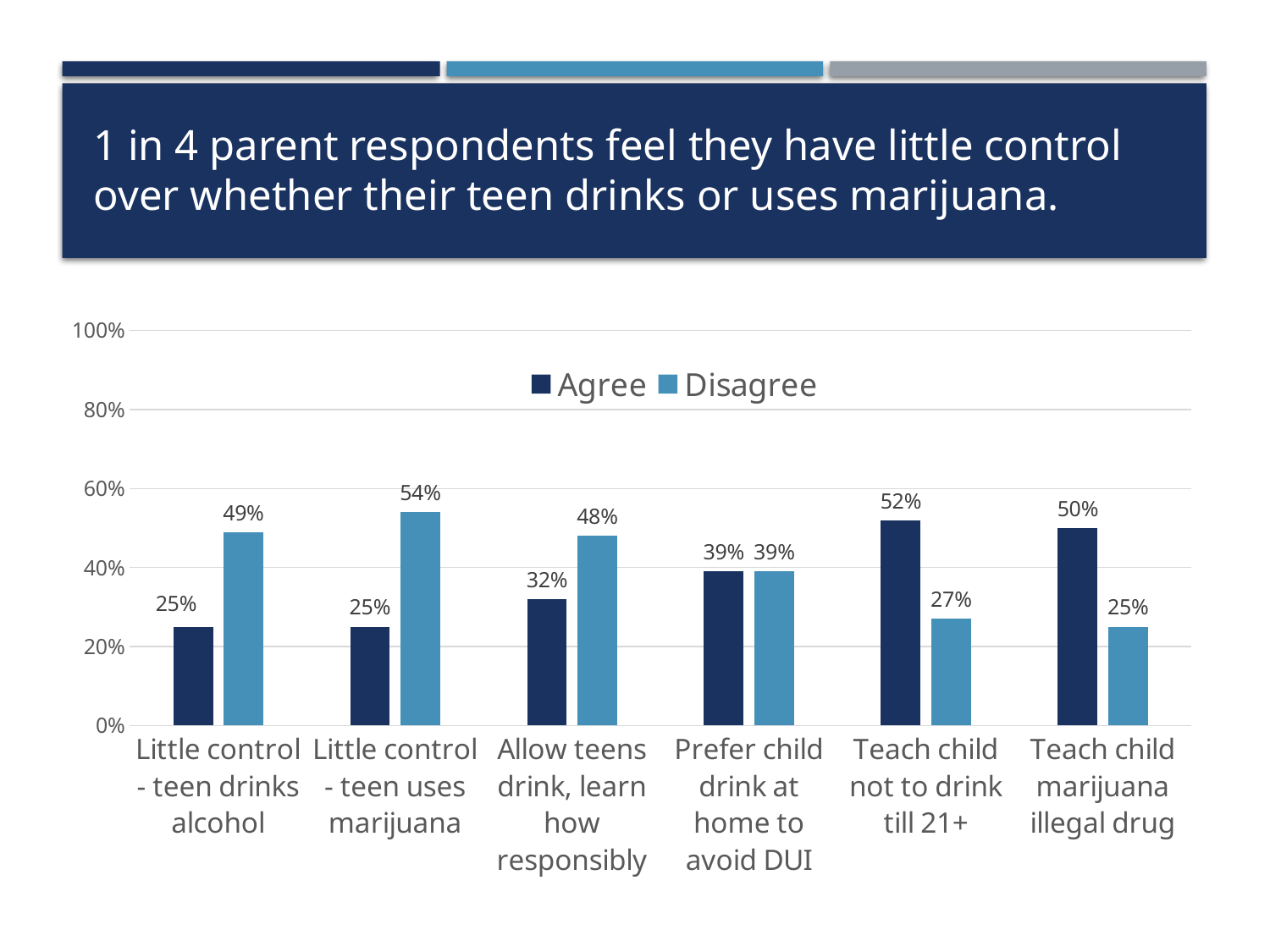
What is the Agree value for "Teach child not to drink till 21+"? 52% Which series is shown in dark navy blue? Agree What is the difference between the Disagree and Agree values for "Allow teens drink, learn how responsibly"? 16% How many categories are shown on the x axis? 6 Which category has the highest Agree value? Teach child not to drink till 21+ What type of chart is shown on the slide? Bar chart What is the Disagree value for "Little control - teen uses marijuana"? 54% Which category has the lowest Disagree value? Teach child marijuana illegal drug Is the Agree value for "Teach child marijuana illegal drug" larger than its Disagree value? Yes What percentage of parents agree with "Little control - teen drinks alcohol"? 25% For "Prefer child drink at home to avoid DUI", is the Agree value larger than, smaller than, or equal to the Disagree value? equal How many series does the legend list? 2